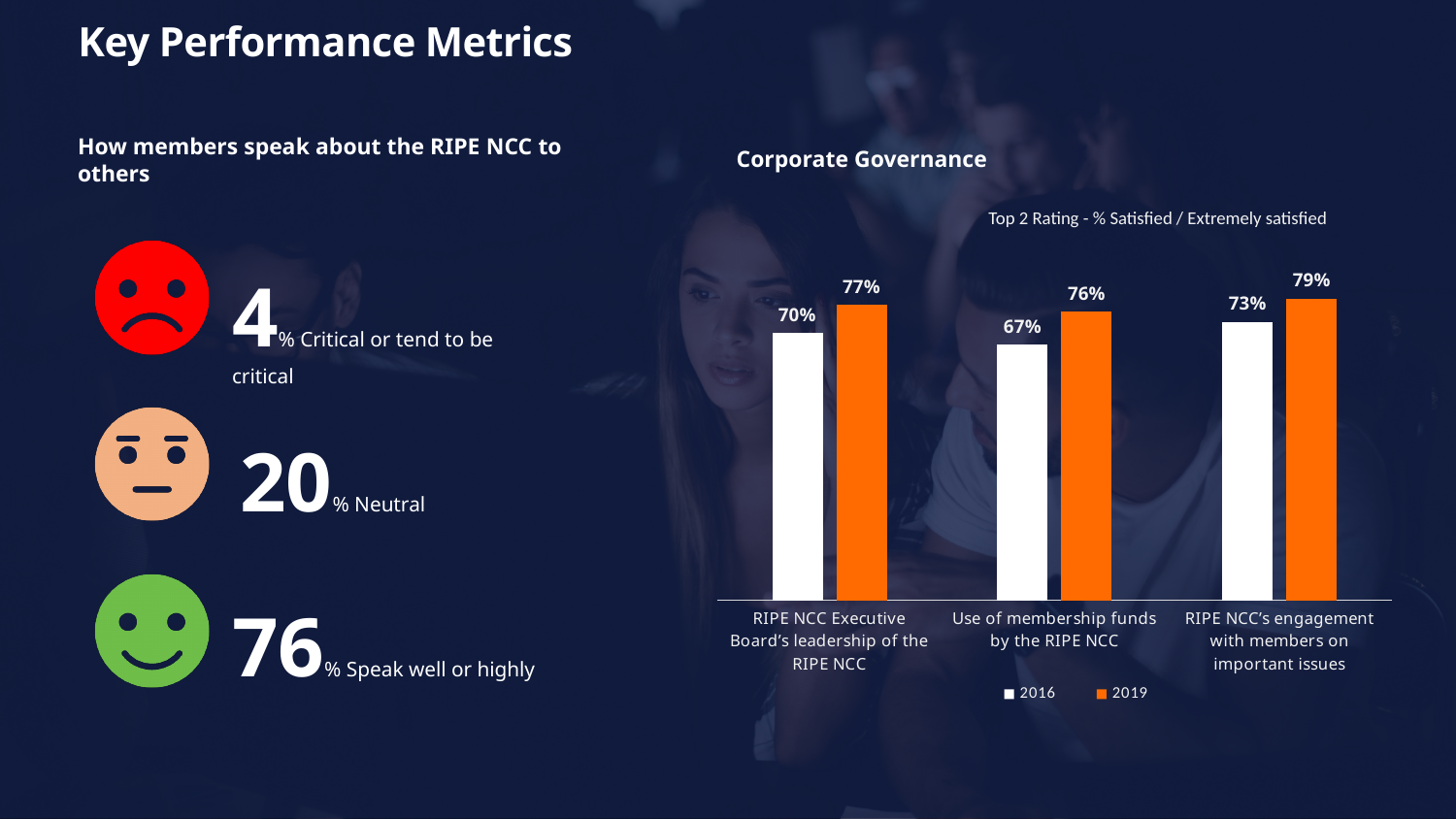
How many series does the legend of the Corporate Governance chart list? 2 What is the 2016 value for 'RIPE NCC Executive Board's leadership of the RIPE NCC'? 70% How many categories are shown on the x axis of the Corporate Governance chart? 3 What is the difference between the 2019 and 2016 values for 'Use of membership funds by the RIPE NCC'? 9% Which category has the lowest 2016 value? Use of membership funds by the RIPE NCC What is the 2019 value for 'Use of membership funds by the RIPE NCC'? 76% What subtitle appears above the Corporate Governance chart describing the rating? Top 2 Rating - % Satisfied / Extremely satisfied Which series is shown in orange in the Corporate Governance chart? 2019 Which is larger for 'RIPE NCC Executive Board's leadership of the RIPE NCC': the 2016 value or the 2019 value? 2019 Which category has the highest 2019 value? RIPE NCC's engagement with members on important issues What is the 2019 value for 'RIPE NCC's engagement with members on important issues'? 79% What kind of chart is shown under the Corporate Governance heading? Bar chart